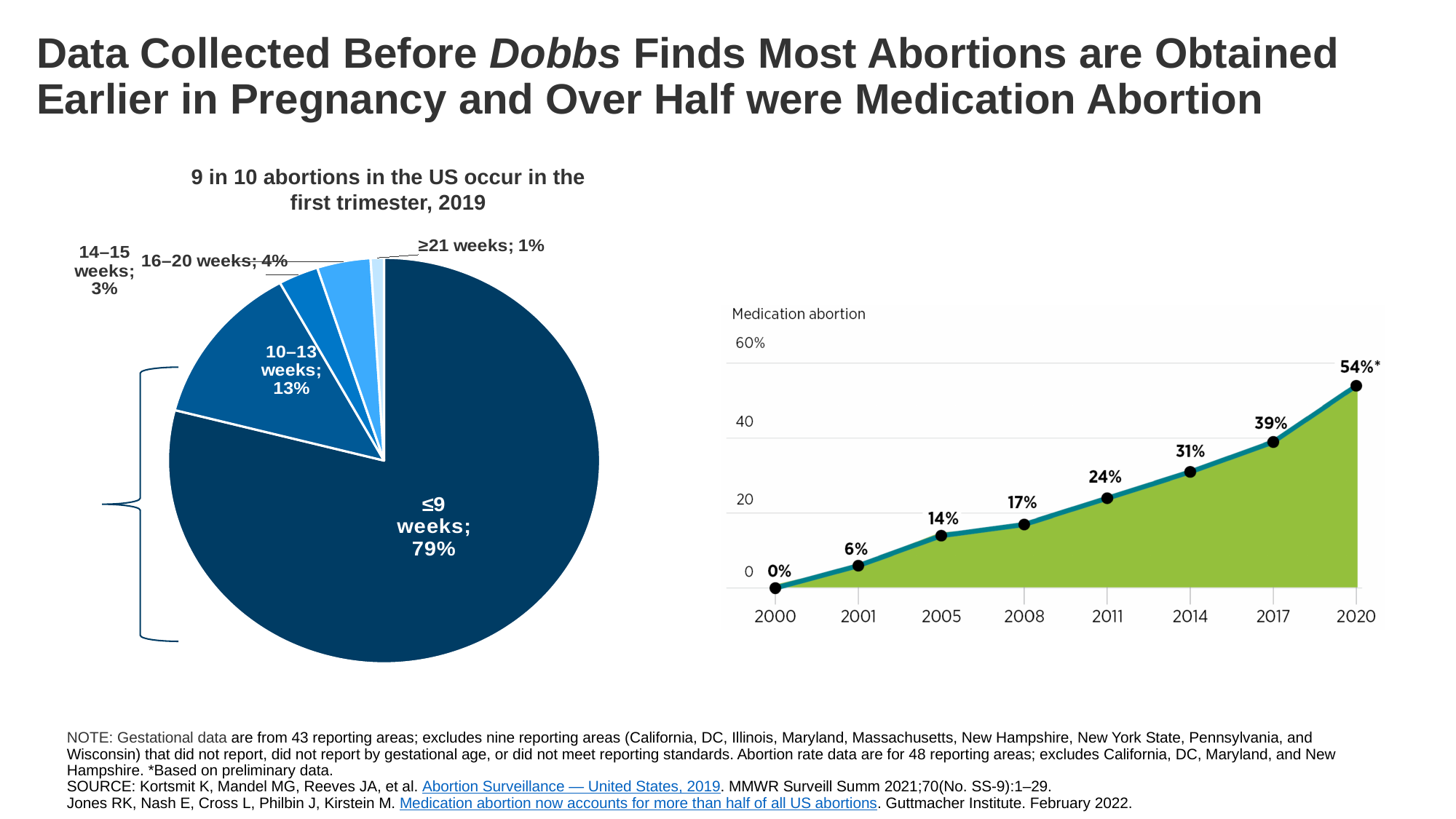
In the 'Medication abortion' chart on the right, which year has the highest value? 2020 In the pie chart on the left, how many gestational age categories are shown? 5 In the pie chart on the left, which gestational age category has the smallest share? ≥21 weeks In the pie chart on the left, what is the difference between the share for ≤9 weeks and the share for 10–13 weeks? 66 percentage points In the 'Medication abortion' chart on the right, how many years are plotted on the x axis? 8 In the 'Medication abortion' chart on the right, what was the value in 2011? 24% In the 'Medication abortion' chart on the right, do the values rise or fall from 2000 to 2020? rise In the pie chart on the left, what share of abortions occurred at ≤9 weeks? 79% In the pie chart on the left, which is larger: the share for 14–15 weeks or the share for 16–20 weeks? 16–20 weeks In the pie chart on the left, what share of abortions occurred at 10–13 weeks? 13% In the 'Medication abortion' chart on the right, what is the difference between the 2017 value and the 2014 value? 8 percentage points In the 'Medication abortion' chart on the right, what was the value in 2020? 54%